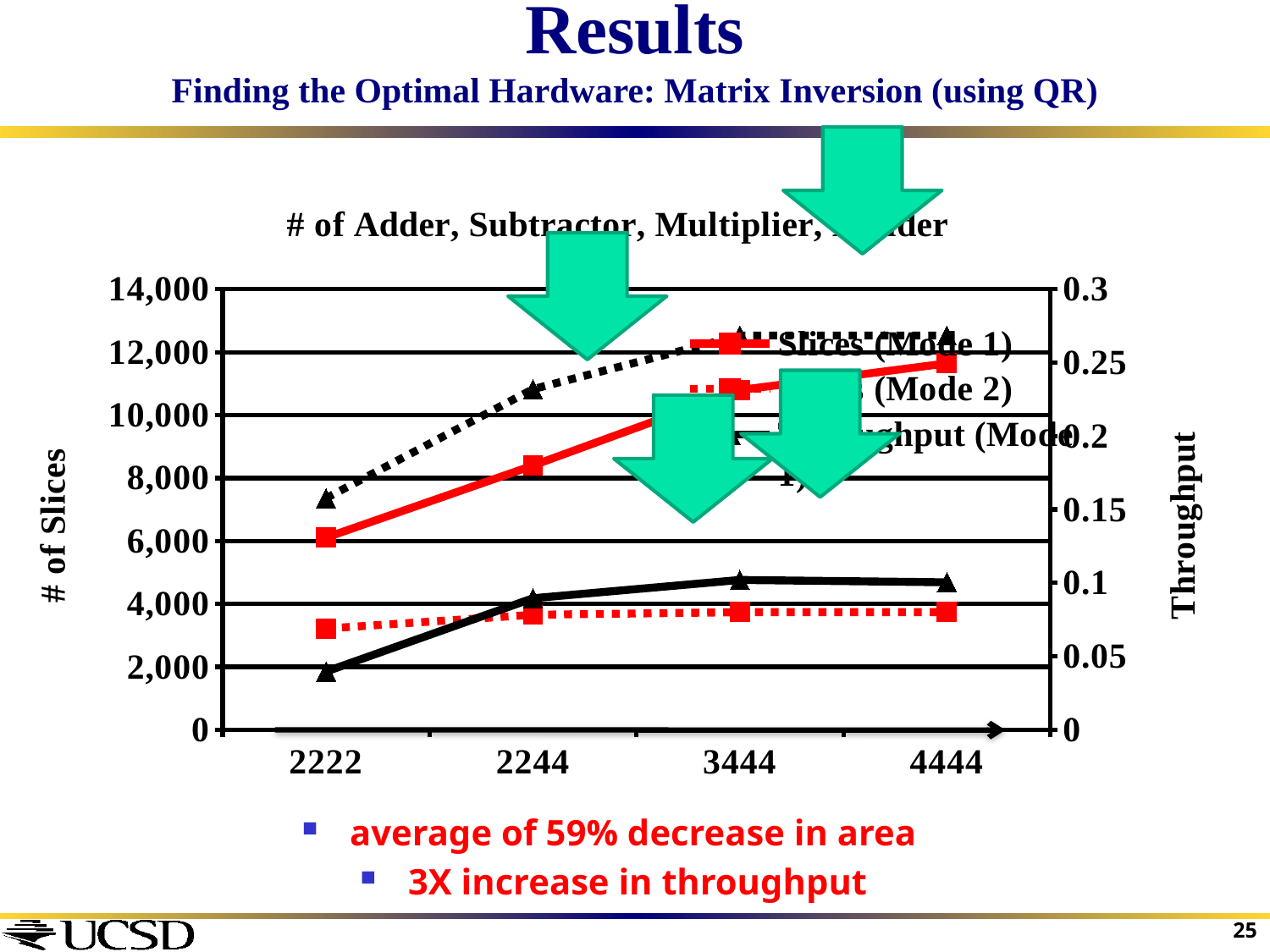
What is the title of the left vertical axis? # of Slices How many lines are plotted on the chart? 4 Does the red solid line rise or fall from 2222 to 4444? rise What kind of chart is shown on the slide? line chart Is the value of the red solid line at 2222 greater or less than 8,000 on the left axis? less Is the value of the red solid line at 4444 greater or less than 10,000 on the left axis? greater At 2222, which is higher: the black dotted line or the red solid line? the black dotted line How many categories are shown on the x axis of the chart? 4 What is the title of the right vertical axis? Throughput Is the value of the black solid line at 2222 greater or less than 0.1 on the right axis? less